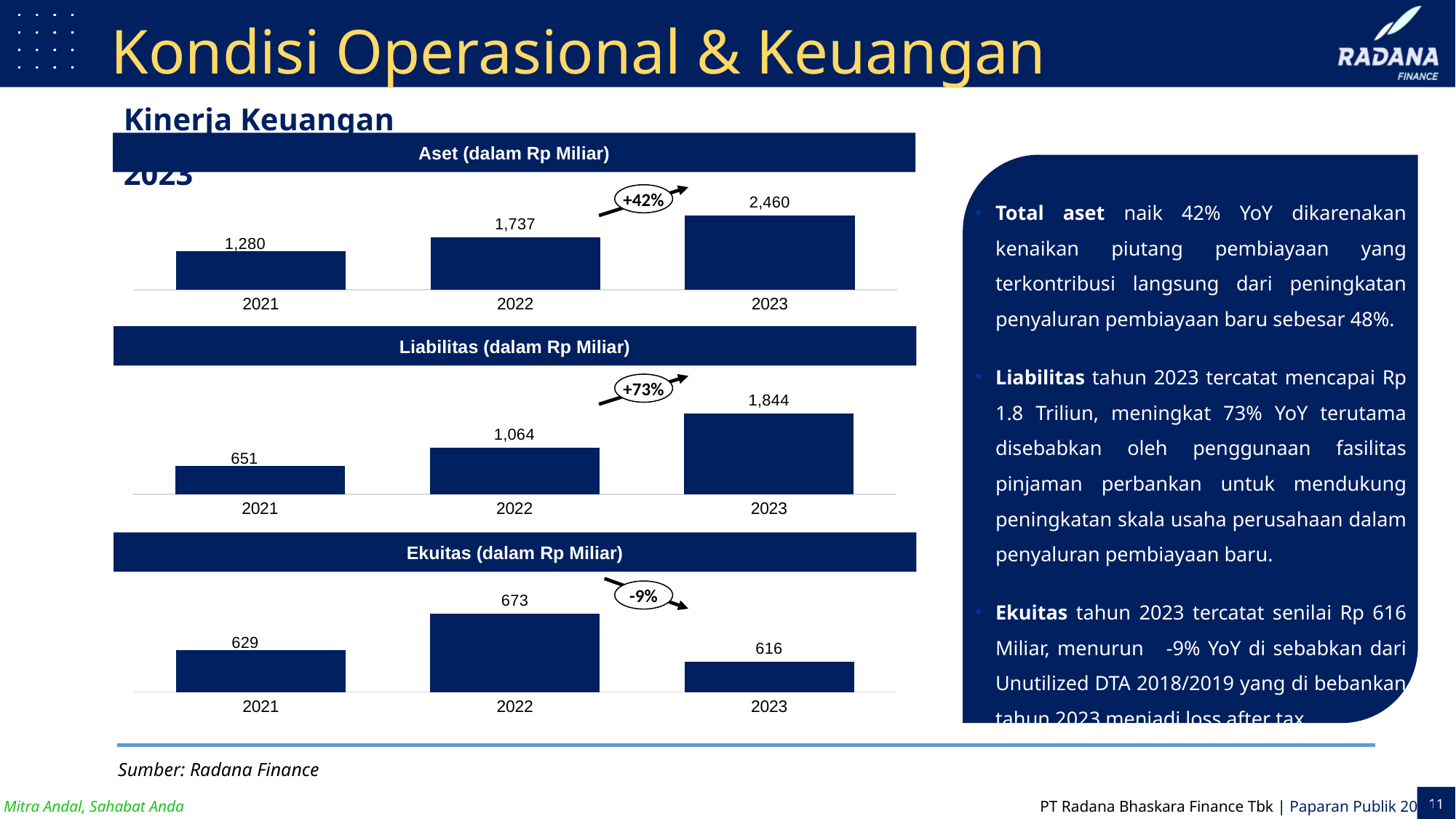
How many years are shown in the 'Aset (dalam Rp Miliar)' chart? 3 In the 'Ekuitas (dalam Rp Miliar)' chart, what is the difference between the 2022 and 2023 values? 57 In the 'Aset (dalam Rp Miliar)' chart, what is the value for 2023? 2,460 In the 'Ekuitas (dalam Rp Miliar)' chart, which year has the highest value? 2022 In the 'Aset (dalam Rp Miliar)' chart, do the values rise or fall from 2021 to 2023? rise In the 'Liabilitas (dalam Rp Miliar)' chart, what is the value for 2022? 1,064 In the 'Liabilitas (dalam Rp Miliar)' chart, is the value for 2023 larger or smaller than the value for 2022? larger In the 'Aset (dalam Rp Miliar)' chart, what is the difference between the 2023 and 2022 values? 723 What kind of chart is the 'Liabilitas (dalam Rp Miliar)' chart? bar chart What percentage change is annotated between 2022 and 2023 in the 'Ekuitas (dalam Rp Miliar)' chart? -9% In the 'Liabilitas (dalam Rp Miliar)' chart, which year has the lowest value? 2021 In the 'Aset (dalam Rp Miliar)' chart, what is the value for 2021? 1,280